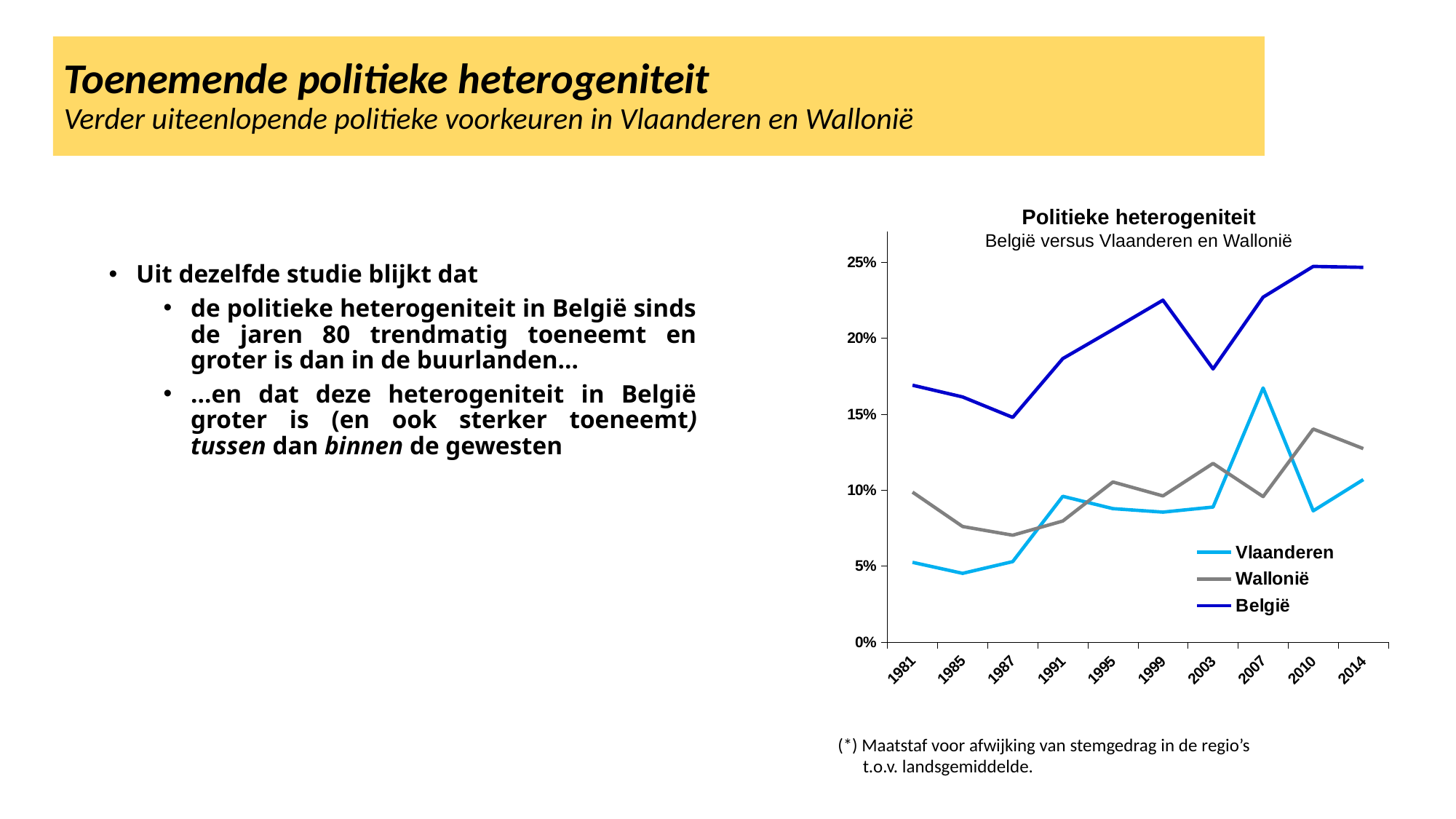
In 2014, which is larger: the value for Wallonië or the value for Vlaanderen? Wallonië Is the value for Vlaanderen in 1985 greater or less than 5%? less What kind of chart is shown on the slide? Line chart In which year does the Vlaanderen series reach its highest value? 2007 In which year does the Vlaanderen series have its lowest value? 1985 What is the title of the chart? Politieke heterogeniteit In which year does the Wallonië series reach its highest value? 2010 How many series does the legend of the chart list? 3 How many years are shown on the x axis of the chart? 10 In which year does the België series have its lowest value? 1987 Is the value for België in 2010 greater or less than 20%? greater Which series is drawn in dark blue in the chart? België